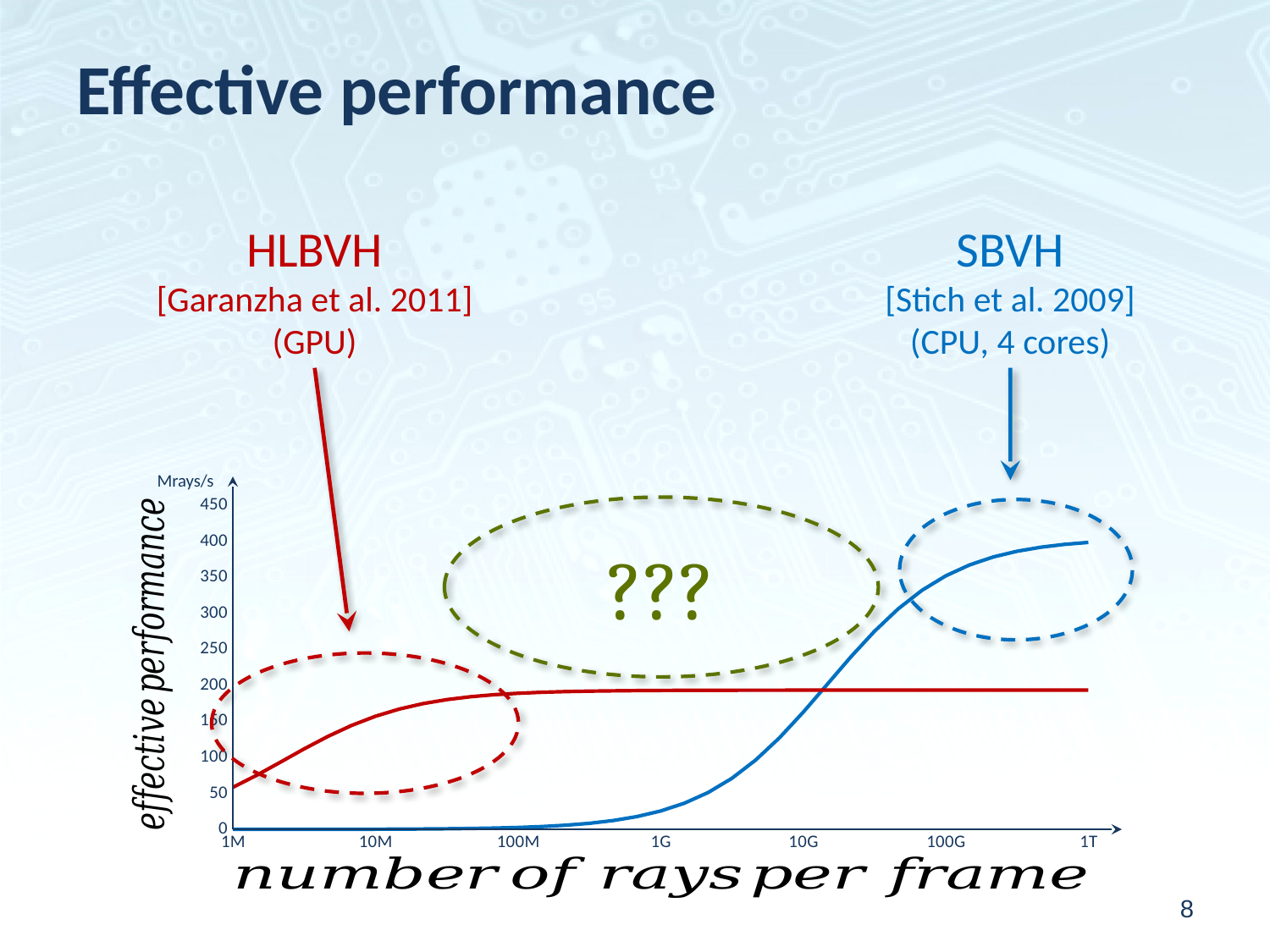
Is the effective performance of the HLBVH curve at 1T rays per frame greater or less than 250 Mrays/s? less Which curve has the higher effective performance at 1T rays per frame, HLBVH or SBVH? SBVH What kind of chart is shown on the slide? line chart Does the SBVH curve rise or fall as the number of rays per frame increases from 1G to 1T? rise What is the title of the slide containing the chart? Effective performance Is the effective performance of the SBVH curve at 100M rays per frame greater or less than 50 Mrays/s? less Is the effective performance of the SBVH curve at 1T rays per frame greater or less than 350 Mrays/s? greater How many curves (series) are plotted on the chart? 2 How many labelled tick marks are there on the x axis (number of rays per frame)? 7 What unit is shown at the top of the y axis? Mrays/s Which curve has the higher effective performance at 10M rays per frame, HLBVH or SBVH? HLBVH